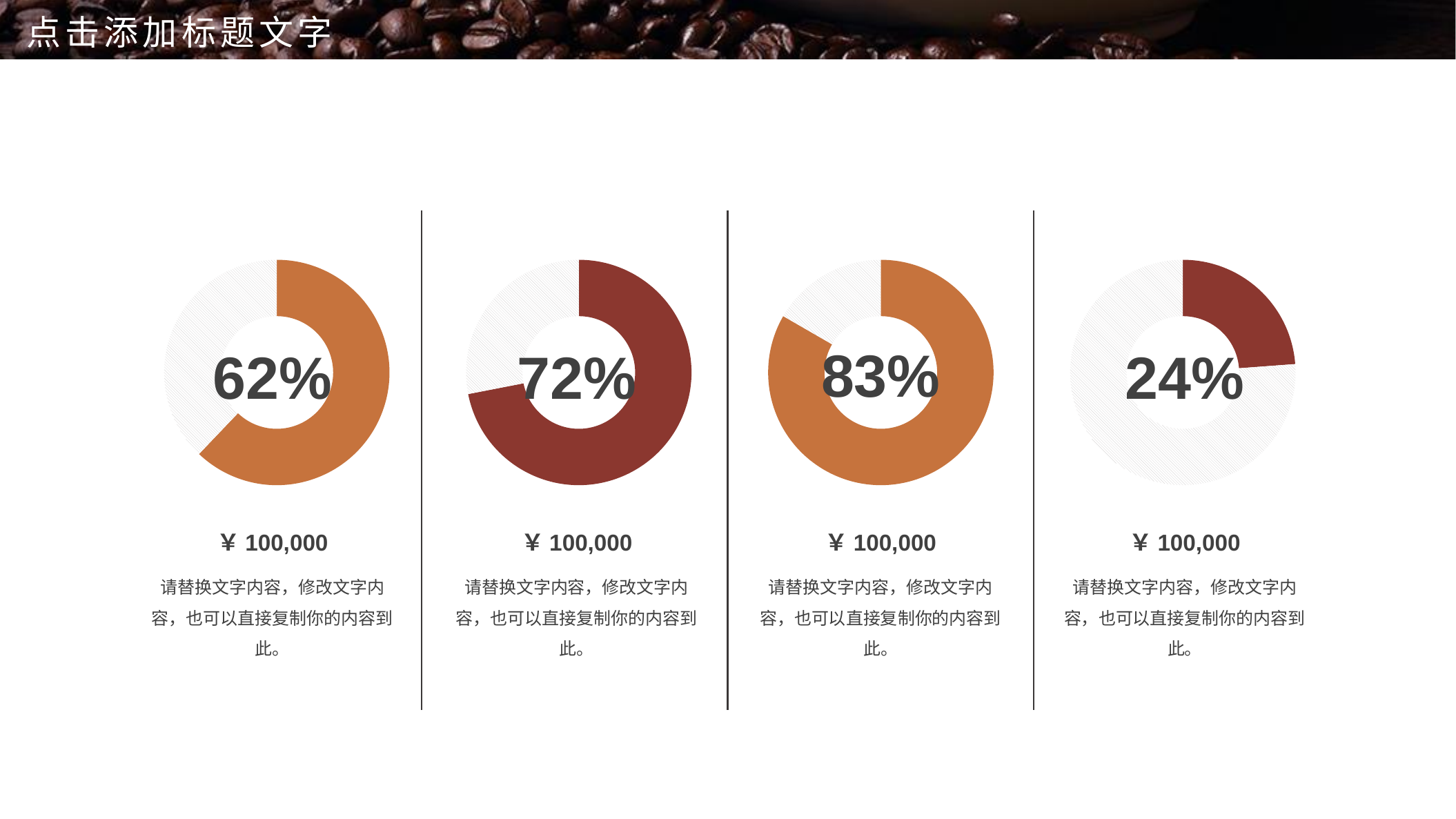
What is the difference between the percentage in the third donut chart (83%) and the rightmost donut chart (24%)? 59% Which of the four donut charts shows the highest percentage? The third from the left (83%) Which is larger, the percentage in the leftmost donut chart or the second donut chart from the left? The second from the left (72%) What colour is the filled portion of the rightmost donut chart? Dark red What percentage is shown in the centre of the third donut chart from the left? 83% What amount is printed below the leftmost donut chart? ¥ 100,000 What percentage is shown in the centre of the leftmost donut chart? 62% What percentage is shown in the centre of the rightmost donut chart? 24% What percentage is shown in the centre of the second donut chart from the left? 72% Which of the four donut charts shows the lowest percentage? The rightmost (24%) How many donut charts are on the slide? 4 What kind of chart is used for each of the four percentage figures on the slide? Donut chart